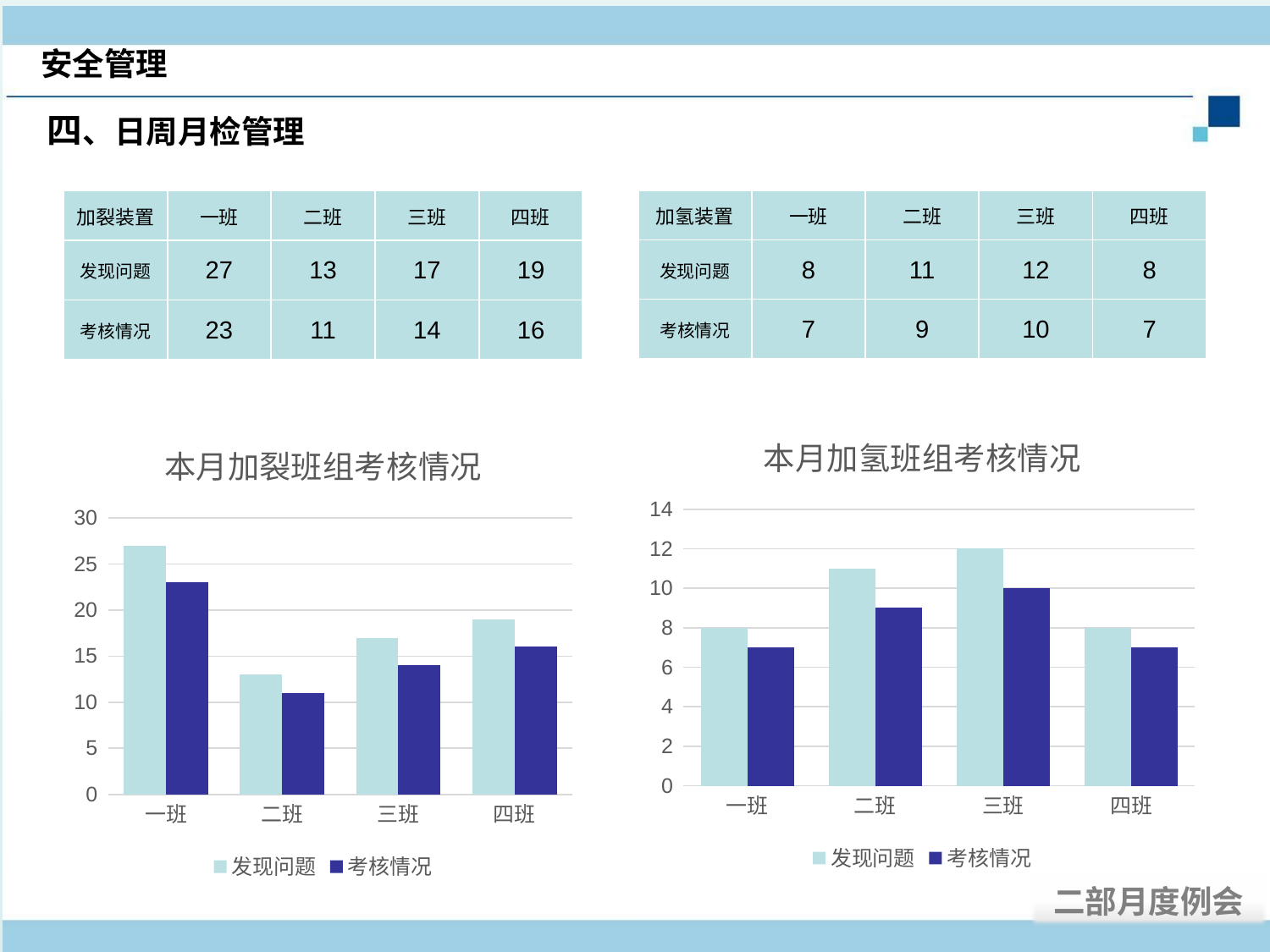
In the 本月加氢班组考核情况 chart, which 班 has the highest 发现问题 value? 三班 In the 本月加氢班组考核情况 chart, what is the 考核情况 value for 三班? 10 How many 班 categories are shown on the x axis of the 本月加氢班组考核情况 chart? 4 What type of chart is the 本月加裂班组考核情况 chart? bar chart In the 本月加裂班组考核情况 chart, which 班 has the highest 发现问题 value? 一班 In the 本月加氢班组考核情况 chart, is the 发现问题 value for 二班 larger than the 发现问题 value for 四班? yes In the 本月加裂班组考核情况 chart, which 班 has the lowest 考核情况 value? 二班 In the 本月加裂班组考核情况 chart, what is the 发现问题 value for 一班? 27 In the 本月加裂班组考核情况 chart, what is the difference between 发现问题 and 考核情况 for 四班? 3 In the 本月加裂班组考核情况 chart, is the 发现问题 value for 二班 greater or less than 15? less How many series does the legend of the 本月加裂班组考核情况 chart list? 2 In the 本月加氢班组考核情况 chart, is the 考核情况 value for 二班 greater or less than 8? greater